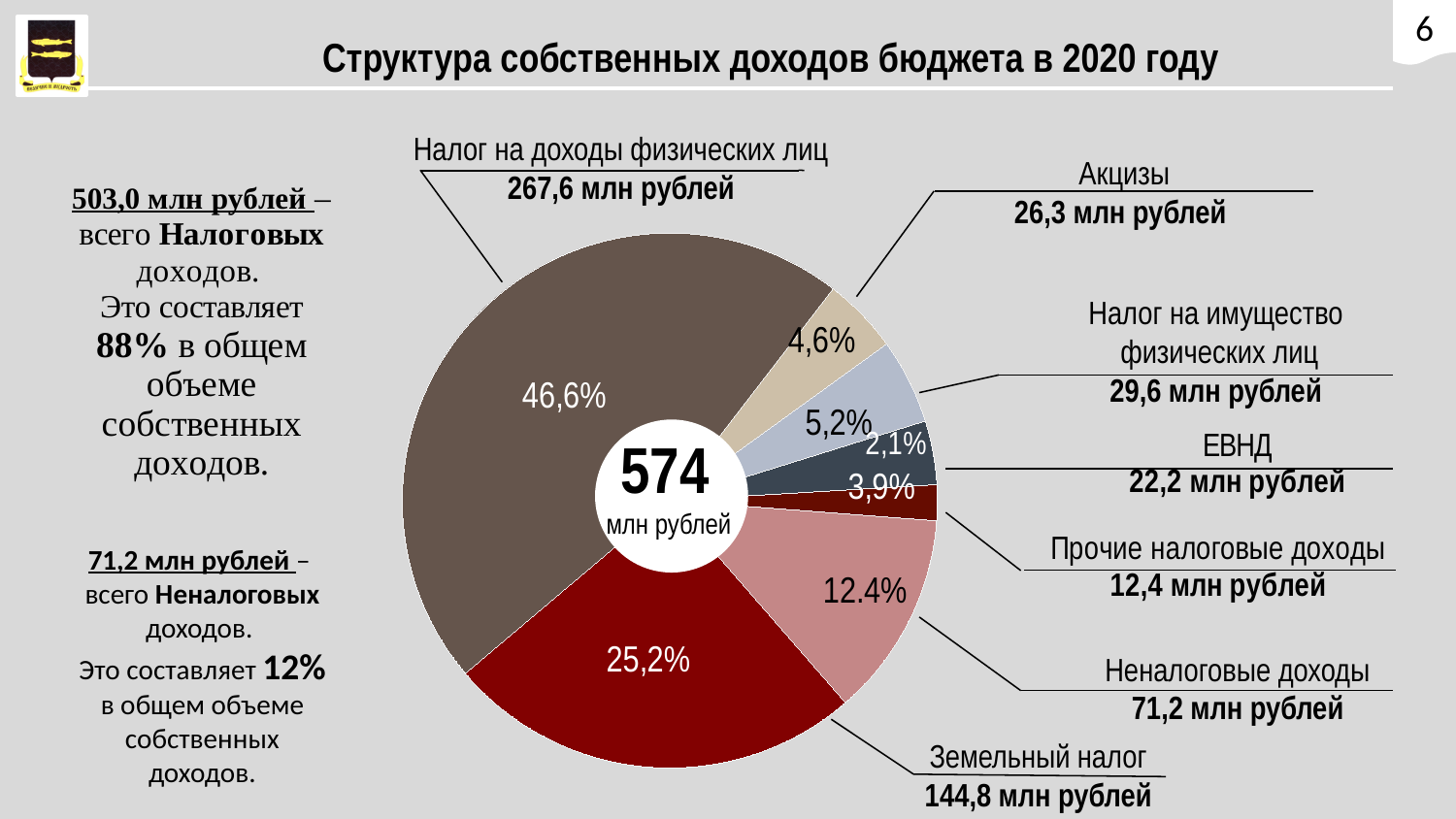
Which category has the smallest slice of the pie? Прочие налоговые доходы What total value is shown in the centre of the chart? 574 млн рублей Which is larger, Акцизы or Налог на имущество физических лиц? Налог на имущество физических лиц What is the difference between Налог на доходы физических лиц and Земельный налог? 122,8 млн рублей What share of the pie does Земельный налог represent? 25,2% What kind of chart is shown on the slide? Pie chart What is the value for Налог на доходы физических лиц? 267,6 млн рублей How many categories are shown in the pie chart? 7 Which category has the largest slice of the pie? Налог на доходы физических лиц What is the value for Земельный налог? 144,8 млн рублей What is the value for ЕВНД? 22,2 млн рублей What is the value for Акцизы? 26,3 млн рублей